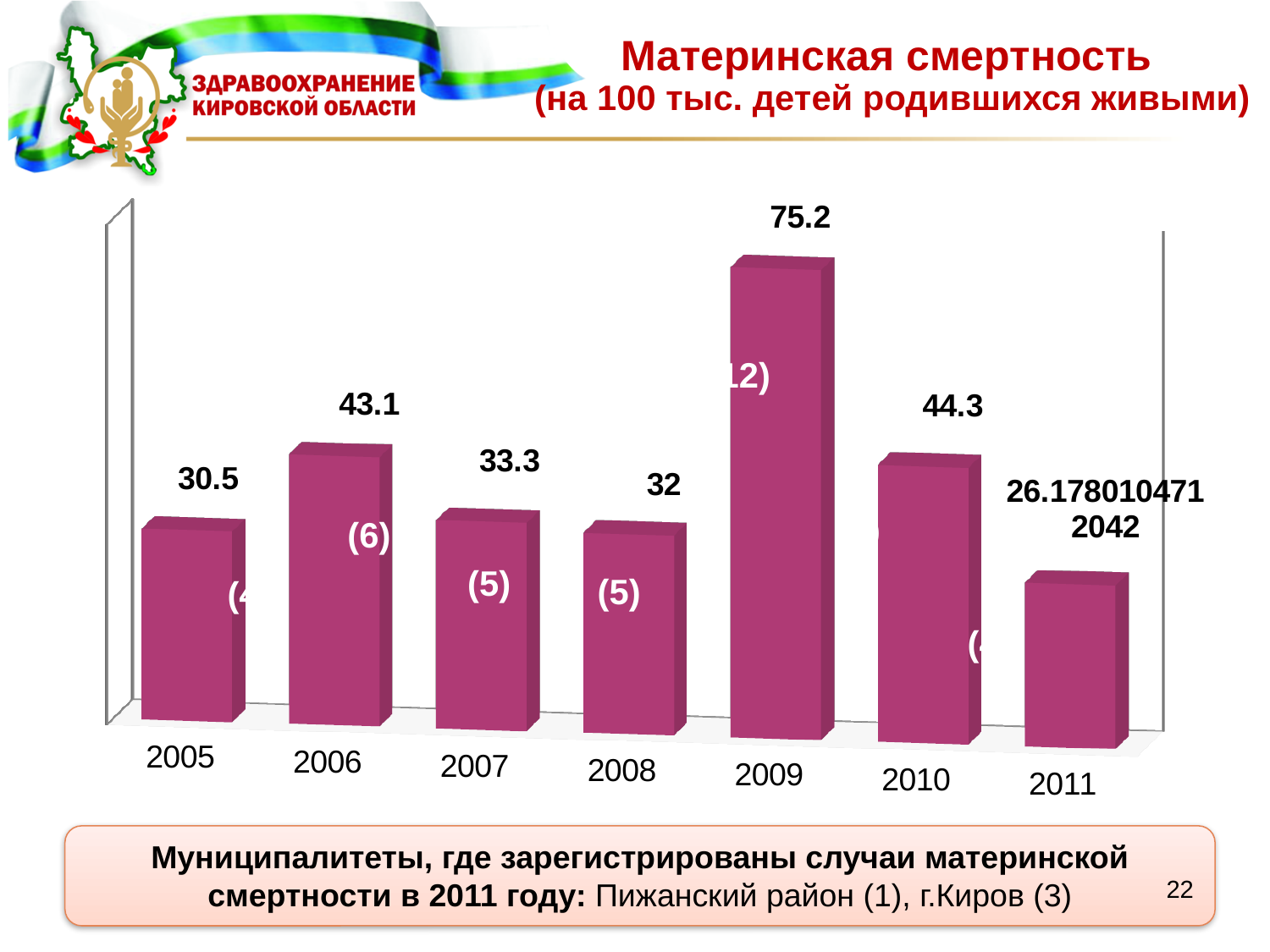
What is the value shown for 2010? 44.3 Which year has the larger value, 2007 or 2010? 2010 What is the difference between the values for 2009 and 2010? 30.9 Which year has the lowest maternal mortality value? 2011 What is the maternal mortality value shown for 2009? 75.2 What is the value shown for 2005? 30.5 What is the difference between the values for 2006 and 2005? 12.6 How many years are shown on the x axis? 7 What kind of chart is shown on the slide? Bar chart Which year has the highest maternal mortality value? 2009 Do the values rise or fall from 2009 to 2011? Fall What is the value shown for 2008? 32